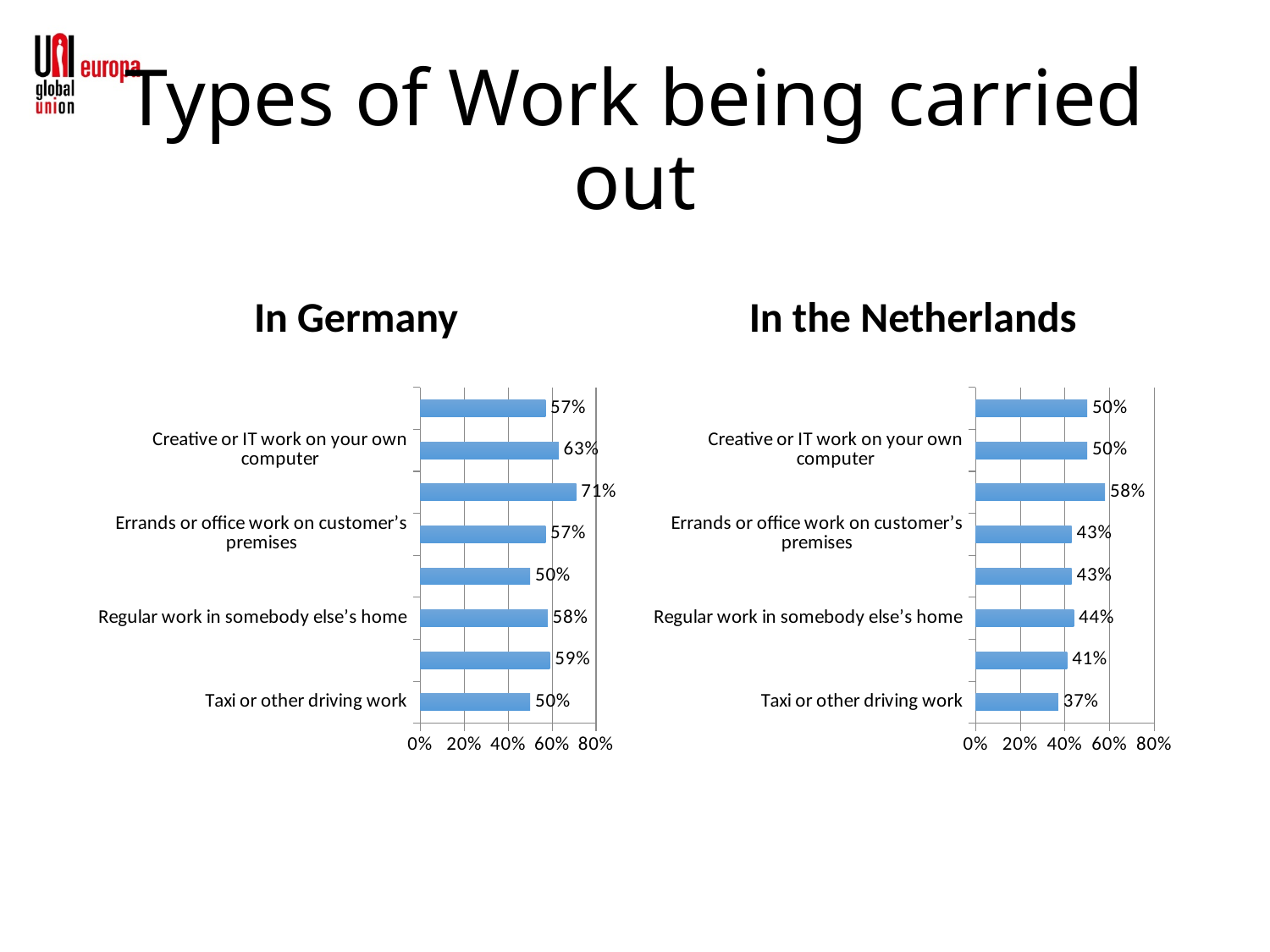
What kind of chart is used for the 'In Germany' data? Bar chart In the 'In the Netherlands' chart, what is the value for 'Errands or office work on customer's premises'? 43% What is the difference between the 'Taxi or other driving work' values in the 'In Germany' chart and the 'In the Netherlands' chart? 13 percentage points In the 'In the Netherlands' chart, what is the lowest value shown on any bar? 37% In the 'In Germany' chart, what is the highest value shown on any bar? 71% In the 'In Germany' chart, what is the value for 'Regular work in somebody else's home'? 58% Which chart shows the larger value for 'Taxi or other driving work', 'In Germany' or 'In the Netherlands'? In Germany In the 'In Germany' chart, what is the value for 'Taxi or other driving work'? 50% In the 'In Germany' chart, what is the value for 'Errands or office work on customer's premises'? 57% In the 'In the Netherlands' chart, what is the value for 'Taxi or other driving work'? 37% In the 'In the Netherlands' chart, what is the value for 'Regular work in somebody else's home'? 44% How many bars are plotted in the 'In the Netherlands' chart? 8